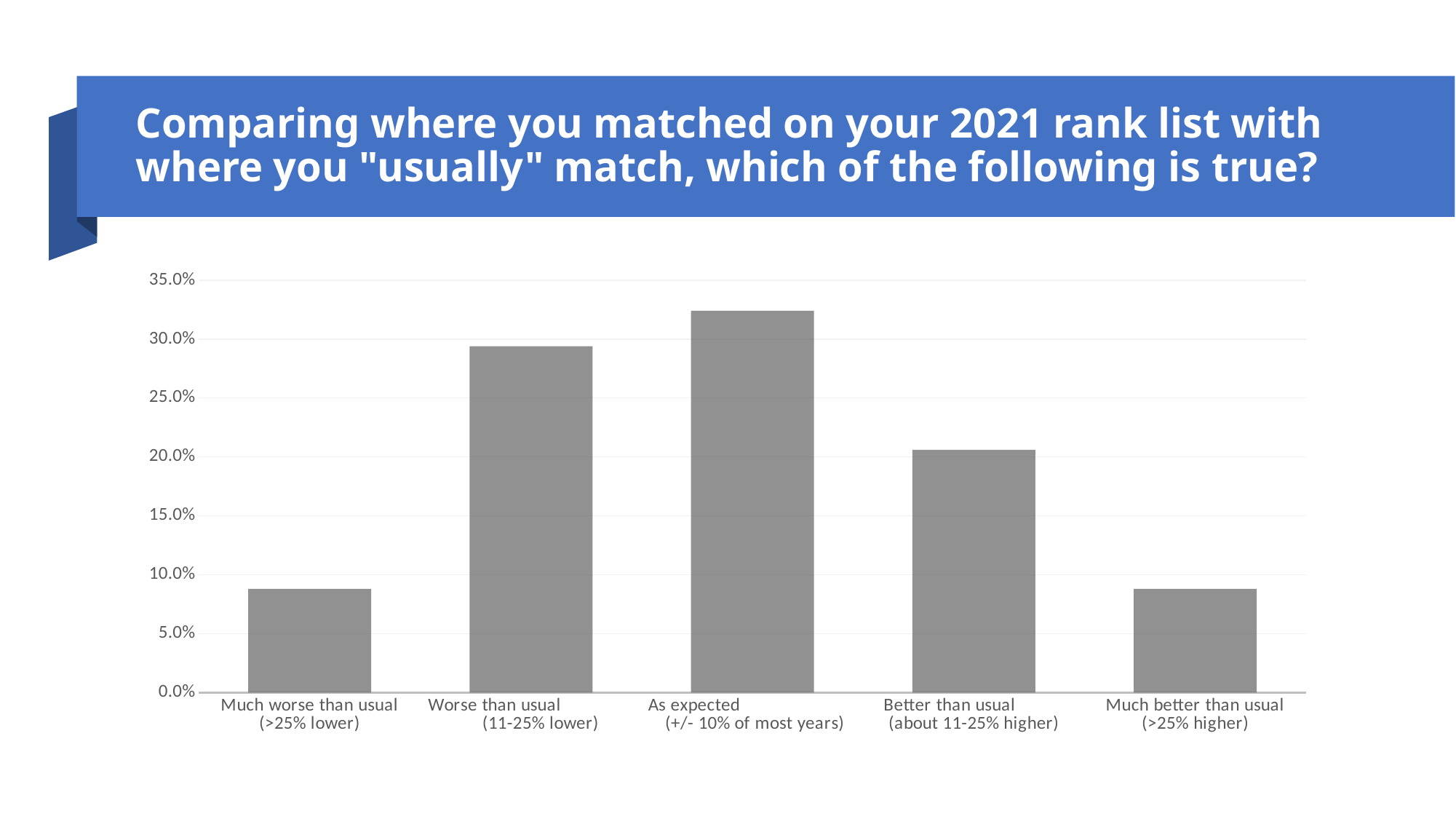
How many categories are shown on the x axis of the chart? 5 Is the value for "As expected (+/- 10% of most years)" greater or less than 30.0%? greater Which is larger, the value for "As expected (+/- 10% of most years)" or the value for "Much worse than usual (>25% lower)"? As expected (+/- 10% of most years) What is the highest value shown on the y axis of the chart? 35.0% Is the value for "Much better than usual (>25% higher)" greater or less than 5.0%? greater What kind of chart is shown on the slide? bar chart Which category has the highest bar? As expected (+/- 10% of most years) What question does the slide title ask? Comparing where you matched on your 2021 rank list with where you "usually" match, which of the following is true? Which is larger, the value for "Worse than usual (11-25% lower)" or the value for "Better than usual (about 11-25% higher)"? Worse than usual (11-25% lower) Is the value for "Better than usual (about 11-25% higher)" greater or less than 25.0%? less